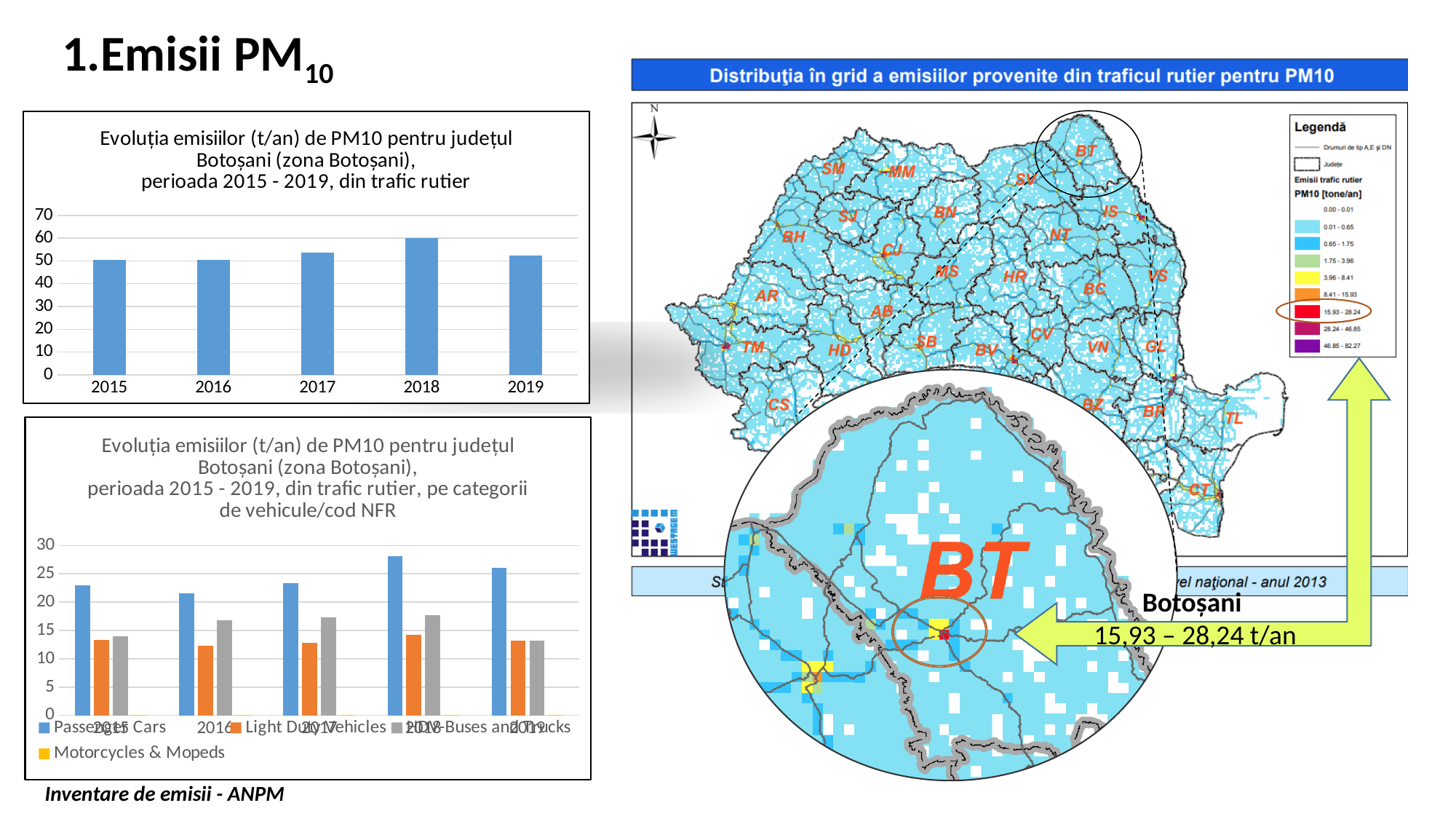
In the top-left chart (PM10 emissions 2015-2019 from road traffic), which is larger, the value for 2018 or the value for 2016? 2018 In the bottom-left chart (PM10 emissions by vehicle category), is the Light Duty Vehicles value for 2016 greater or less than 15? less What kind of chart is the top-left chart titled 'Evoluția emisiilor (t/an) de PM10 pentru județul Botoșani (zona Botoșani), perioada 2015 - 2019, din trafic rutier'? bar chart In the top-left chart (PM10 emissions 2015-2019 from road traffic), is the value for 2018 greater or less than 50? greater In the bottom-left chart (PM10 emissions by vehicle category), in which year is the Passenger Cars value highest? 2018 In the bottom-left chart (PM10 emissions by vehicle category), is the Passenger Cars value for 2018 greater or less than 25? greater In the bottom-left chart (PM10 emissions by vehicle category), which series has the lowest value in every year? Motorcycles & Mopeds In the top-left chart (PM10 emissions 2015-2019 from road traffic), which year has the highest value? 2018 How many series does the legend of the bottom-left chart (PM10 emissions by vehicle category) list? 4 How many years are shown on the x axis of the top-left chart (PM10 emissions 2015-2019 from road traffic)? 5 In the bottom-left chart (PM10 emissions by vehicle category), which is larger in 2015, Passenger Cars or Light Duty Vehicles? Passenger Cars